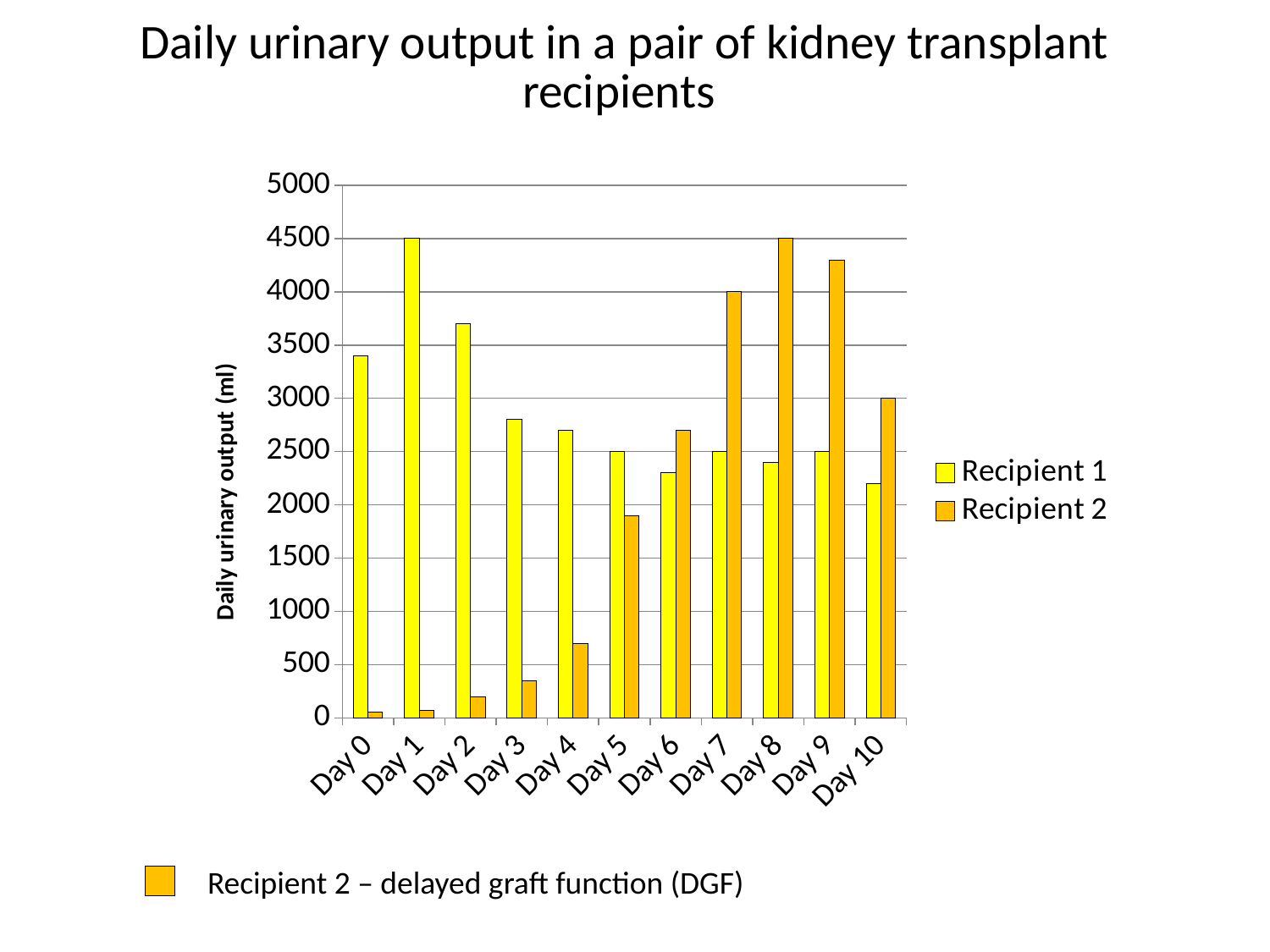
What is the daily urinary output for Recipient 2 on Day 8? 4500 What is the daily urinary output for Recipient 1 on Day 1? 4500 On Day 9, which recipient has the larger urinary output? Recipient 2 Is the value for Recipient 2 on Day 3 greater or less than 500? less How many series does the legend list? 2 How many days are shown on the x axis? 11 What is the label of the vertical axis? Daily urinary output (ml) On which day is Recipient 1's urinary output highest? Day 1 What is the daily urinary output for Recipient 2 on Day 7? 4000 Is the value for Recipient 1 on Day 0 greater or less than 3000? greater On which day is Recipient 2's urinary output highest? Day 8 What kind of chart is shown on the slide? bar chart